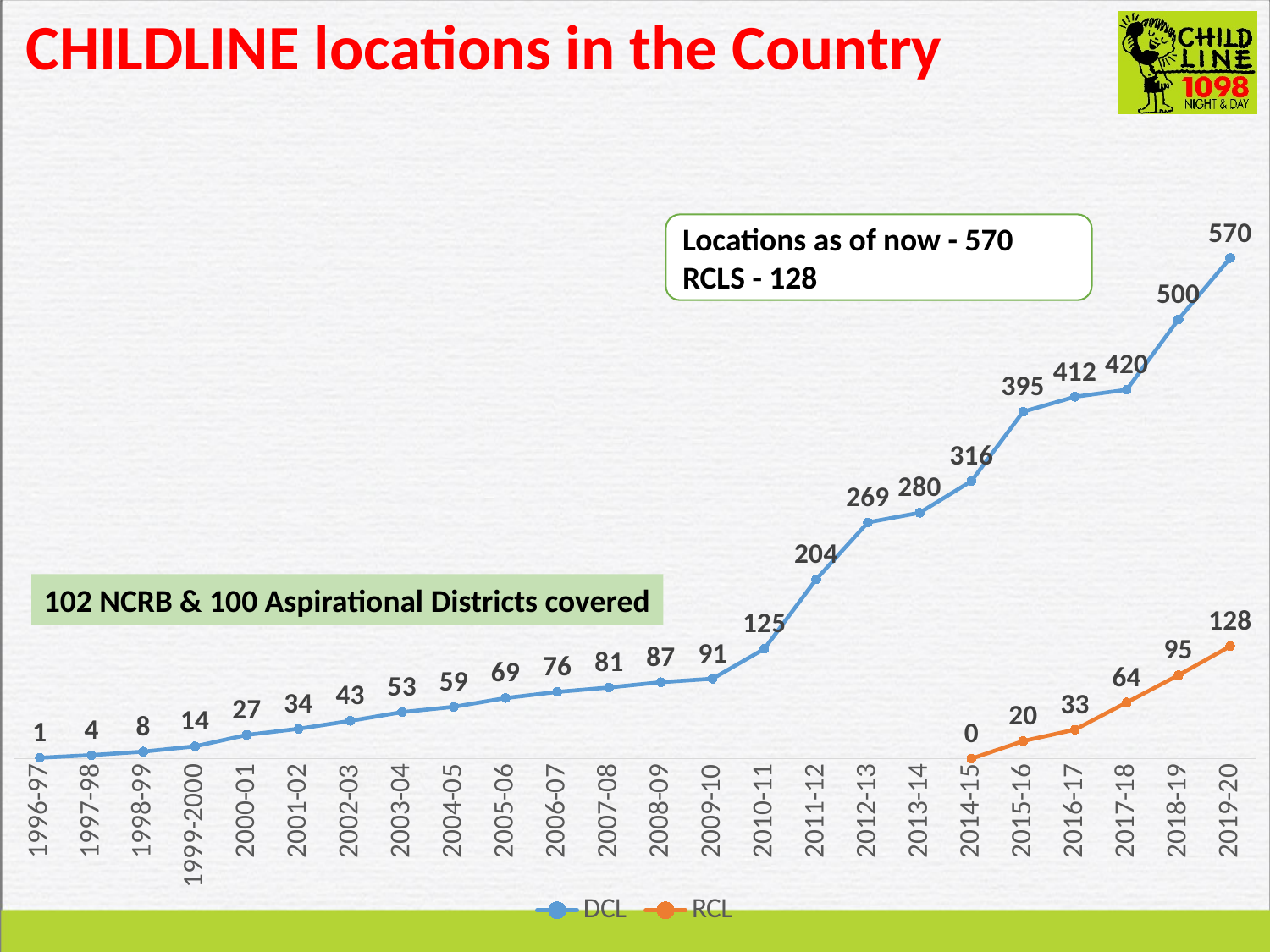
What colour is the RCL line? Orange Which year has the lowest DCL value? 1996-97 Do the DCL values rise or fall from 1996-97 to 2019-20? Rise What kind of chart is shown on the slide? Line chart Which is larger, the DCL value for 2012-13 or the DCL value for 2013-14? 2013-14 How many series does the legend list? 2 Which year has the highest DCL value? 2019-20 What is the RCL value for 2017-18? 64 What is the DCL value for 2010-11? 125 What is the difference between the DCL values for 2019-20 and 2018-19? 70 How many years are shown on the x axis? 24 What is the DCL value for 2019-20? 570